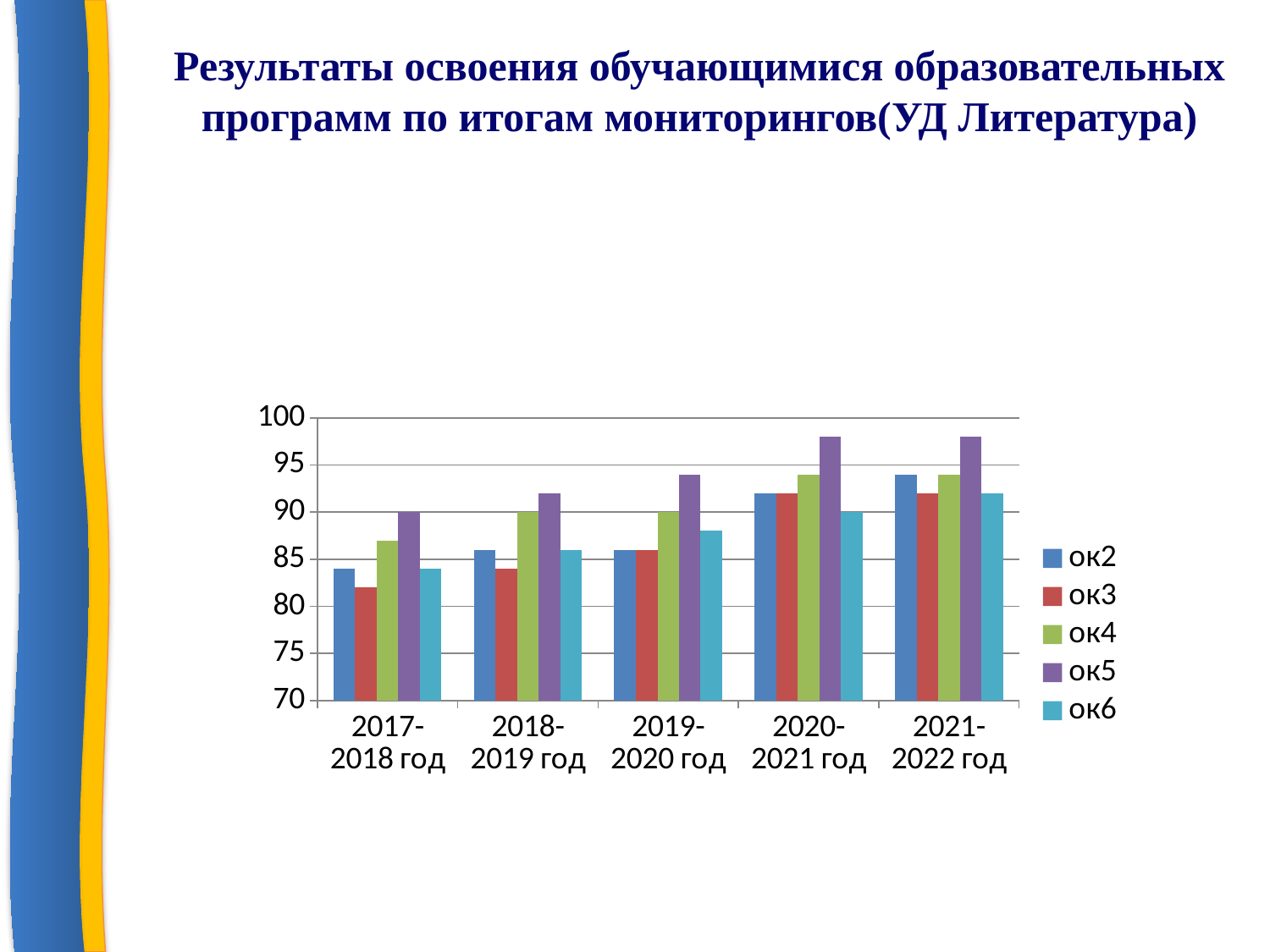
Which series has the highest value in 2017-2018 год? ок5 What kind of chart is shown on the slide? bar chart Is the value for ок3 in 2017-2018 год greater or less than 85? less Is the value for ок6 in 2019-2020 год greater or less than 90? less Which series has the lowest value in 2020-2021 год? ок6 What is the value for ок4 in 2018-2019 год? 90 What is the value for ок6 in 2020-2021 год? 90 Is the value for ок5 in 2020-2021 год greater or less than 95? greater What is the value for ок5 in 2017-2018 год? 90 How many academic years are shown on the x axis of the chart? 5 Which is larger in 2019-2020 год, the value for ок5 or the value for ок6? ок5 How many series does the chart legend list? 5